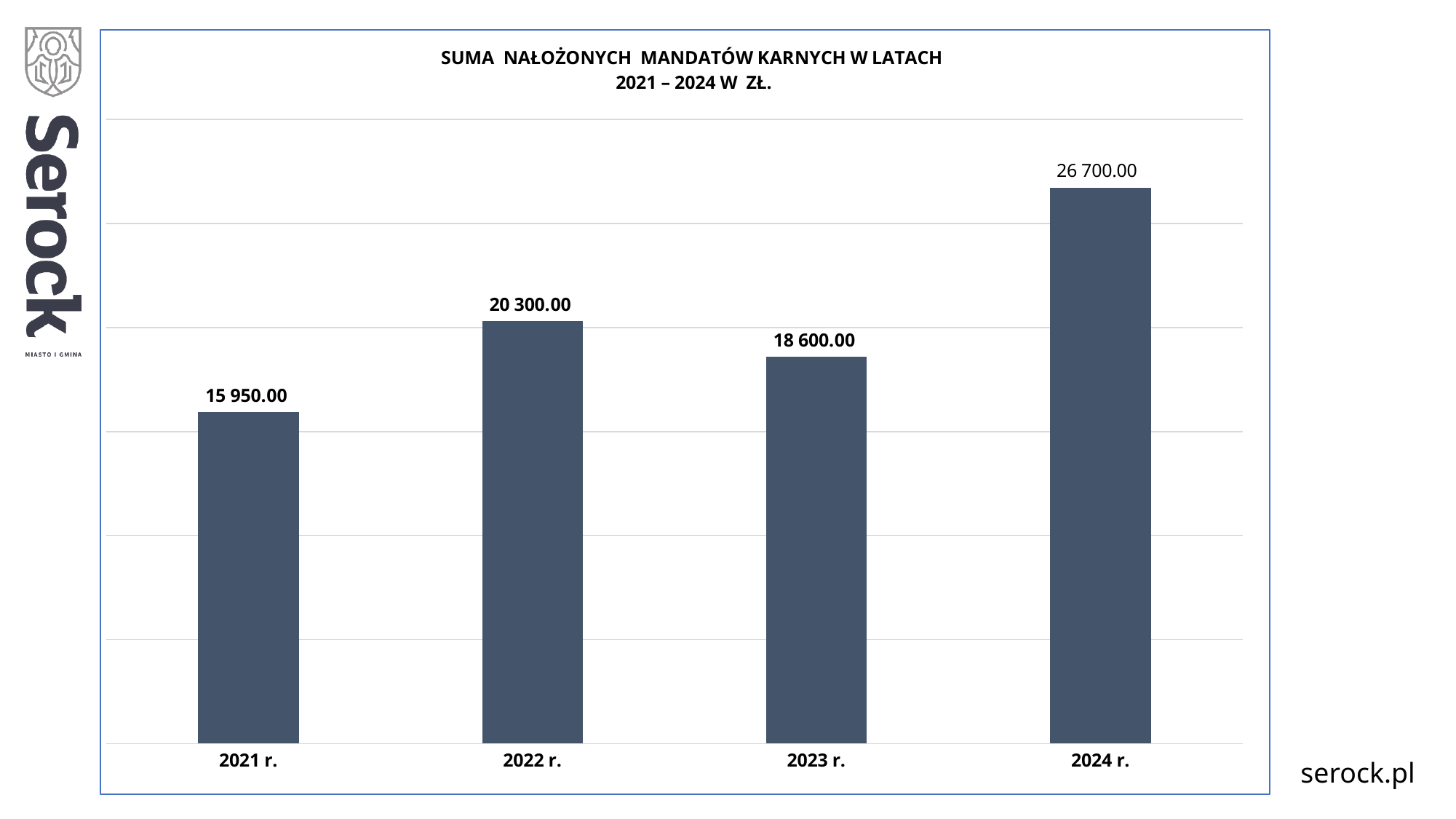
What is the value for 2021 r.? 15 950.00 What is the value for 2023 r.? 18 600.00 What is the difference between the values for 2022 r. and 2023 r.? 1 700.00 How many years are shown on the chart? 4 What kind of chart is shown on the slide? bar chart What is the difference between the values for 2024 r. and 2021 r.? 10 750.00 Which is larger, the value for 2022 r. or the value for 2023 r.? 2022 r. What is the value for 2024 r.? 26 700.00 What is the value for 2022 r.? 20 300.00 Which year has the highest value? 2024 r. Which year has the lowest value? 2021 r. What is the title of the chart? SUMA NAŁOŻONYCH MANDATÓW KARNYCH W LATACH 2021 – 2024 W ZŁ.